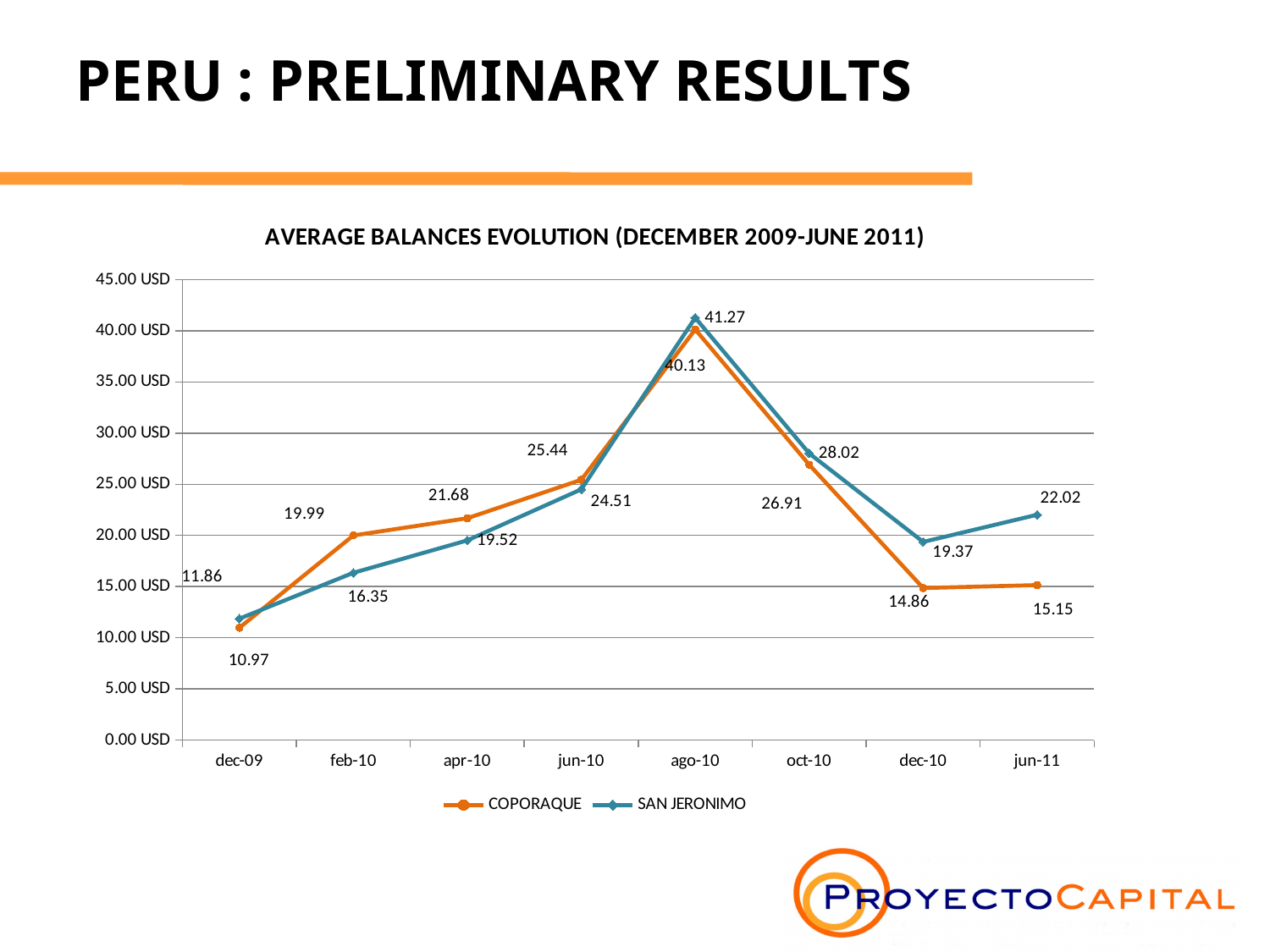
What kind of chart is shown on the slide? Line chart At which date is the SAN JERONIMO value lowest? dec-09 What is the title of the chart? AVERAGE BALANCES EVOLUTION (DECEMBER 2009-JUNE 2011) How many series does the legend list? 2 At dec-10, which series has the higher value, COPORAQUE or SAN JERONIMO? SAN JERONIMO What is the value for COPORAQUE at feb-10? 19.99 Do the COPORAQUE values rise or fall from dec-09 to ago-10? Rise What is the value for SAN JERONIMO at jun-11? 22.02 How many dates are plotted on the x axis? 8 What is the difference between the SAN JERONIMO and COPORAQUE values at ago-10? 1.14 By how much does the SAN JERONIMO value increase from dec-10 to jun-11? 2.65 At which date does COPORAQUE reach its highest value? ago-10